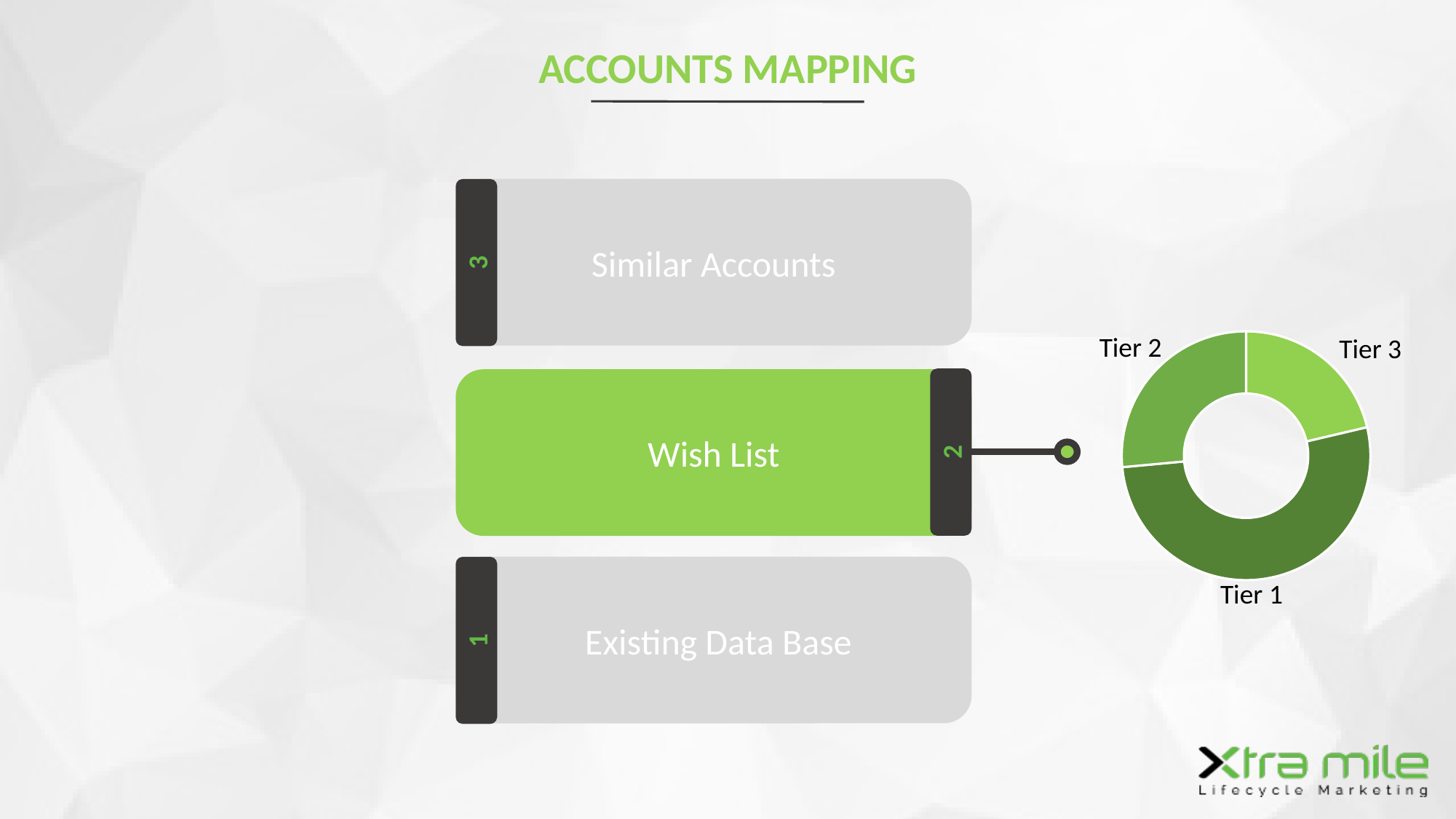
In the donut chart, which slice is larger, Tier 1 or Tier 2? Tier 1 Which tier has the smallest slice in the donut chart? Tier 3 What is the title of the slide containing the donut chart? ACCOUNTS MAPPING What kind of chart is shown on the right of the slide? Pie chart (donut) How many slices does the donut chart have? 3 Which tier has the largest slice in the donut chart? Tier 1 In the donut chart, which slice is larger, Tier 2 or Tier 3? Tier 2 What are the labels of the slices in the donut chart? Tier 1, Tier 2, Tier 3